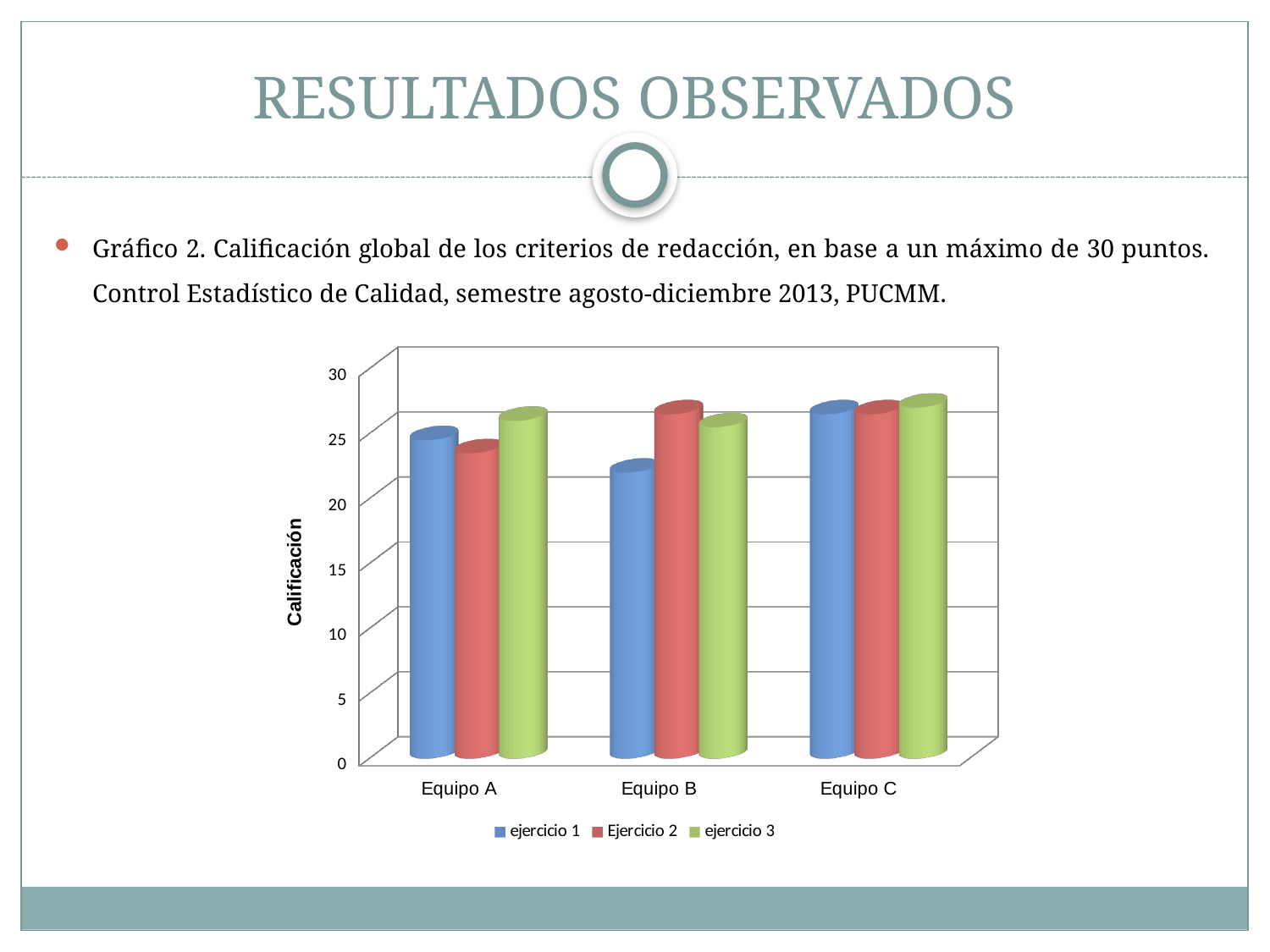
For Equipo B, which is larger: the value for ejercicio 1 or the value for Ejercicio 2? Ejercicio 2 What kind of chart is shown on the slide? bar chart Is the value for ejercicio 1 for Equipo B greater or less than 20? greater Which team has the highest value for ejercicio 1? Equipo C How many series does the chart legend list? 3 Is the value for ejercicio 1 for Equipo B greater or less than 25? less Is the value for Ejercicio 2 for Equipo A greater or less than 25? less What is the title of the vertical axis of the chart? Calificación Which team has the lowest value for ejercicio 1? Equipo B Which series is shown in blue in the chart legend? ejercicio 1 How many teams (categories) are shown on the x axis of the chart? 3